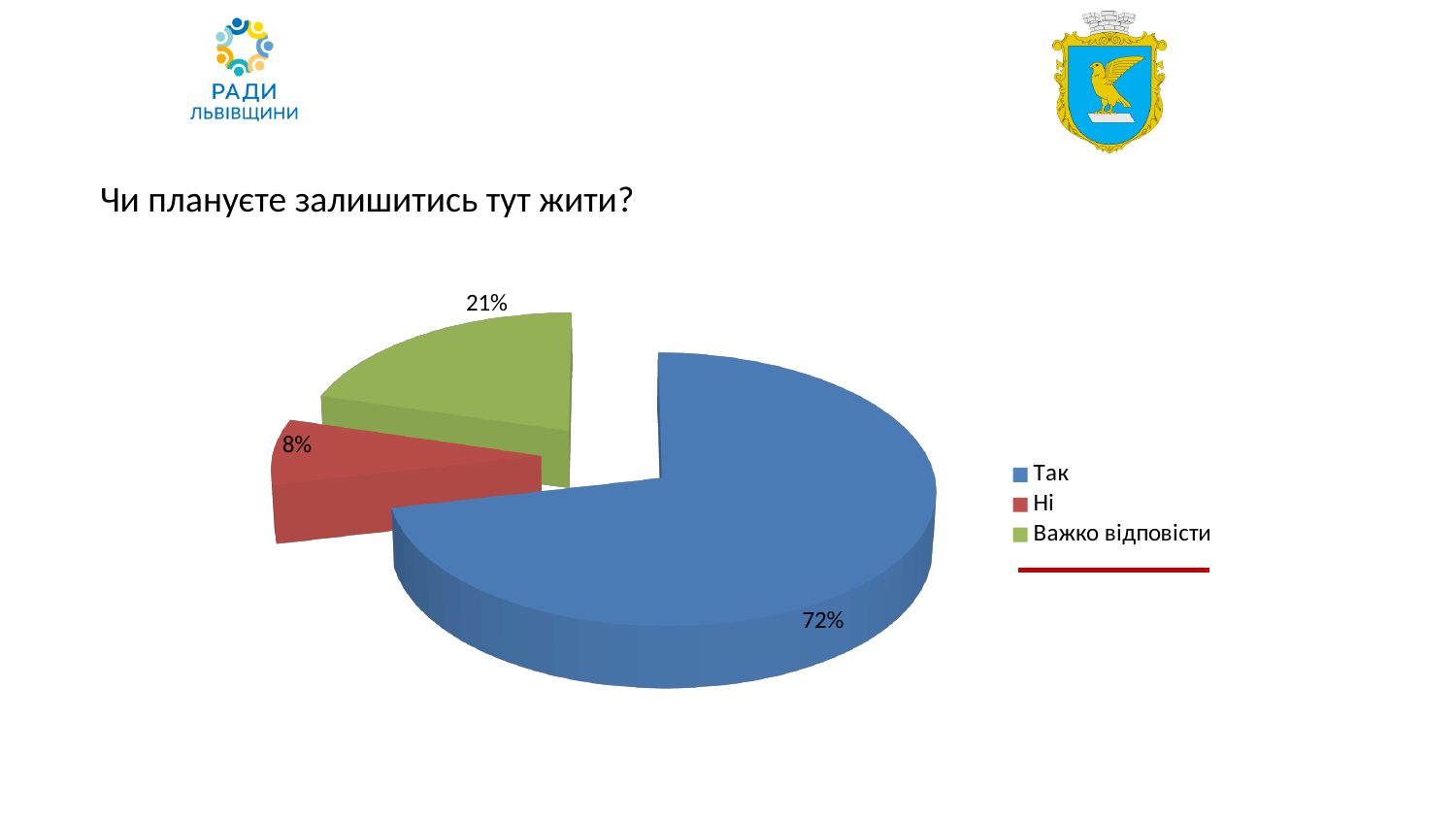
Which category has the smallest slice of the pie? Ні What is the difference in percentage points between "Так" and "Важко відповісти"? 51 How many categories does the pie chart have? 3 What share of the pie does "Так" have? 72% Which category has the largest slice of the pie? Так What question is the chart answering, according to the slide title? Чи плануєте залишитись тут жити? What colour is the slice for "Ні"? red What is the difference in percentage points between "Важко відповісти" and "Ні"? 13 What share of the pie does "Ні" have? 8% Which is larger, the share for "Ні" or the share for "Важко відповісти"? Важко відповісти What share of the pie does "Важко відповісти" have? 21% What kind of chart is shown on the slide? pie chart